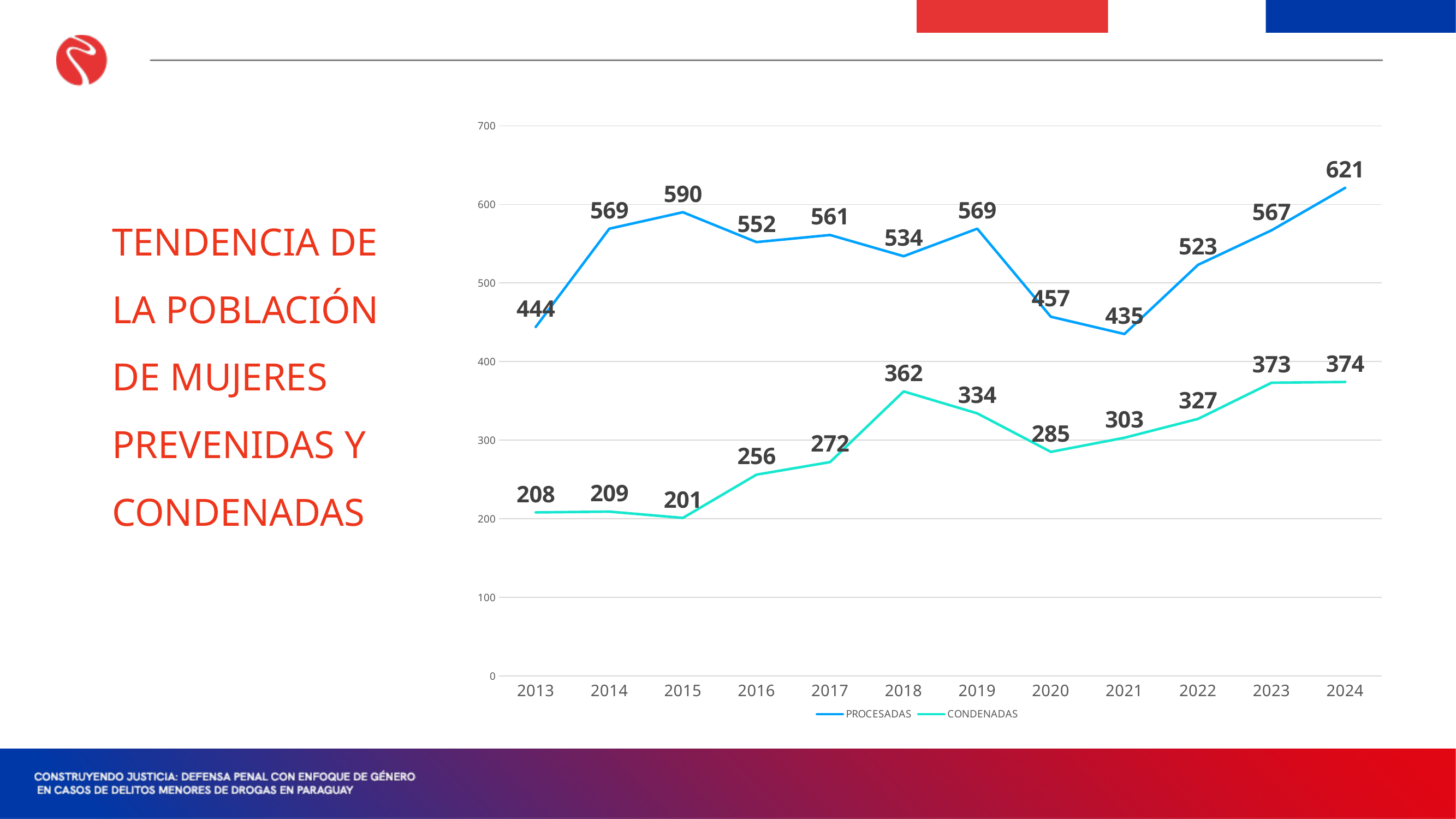
What is the PROCESADAS value for 2015? 590 Does the CONDENADAS series rise or fall from 2021 to 2024? Rise What is the difference between PROCESADAS and CONDENADAS in 2024? 247 In which year is the PROCESADAS value highest? 2024 What kind of chart is shown on the slide? Line chart What are the two series named in the legend? PROCESADAS and CONDENADAS How many series does the legend list? 2 How many years are shown on the x axis? 12 In which year is the CONDENADAS value lowest? 2015 What is the CONDENADAS value for 2018? 362 What is the PROCESADAS value for 2021? 435 Which is larger, the PROCESADAS value in 2019 or in 2020? 2019